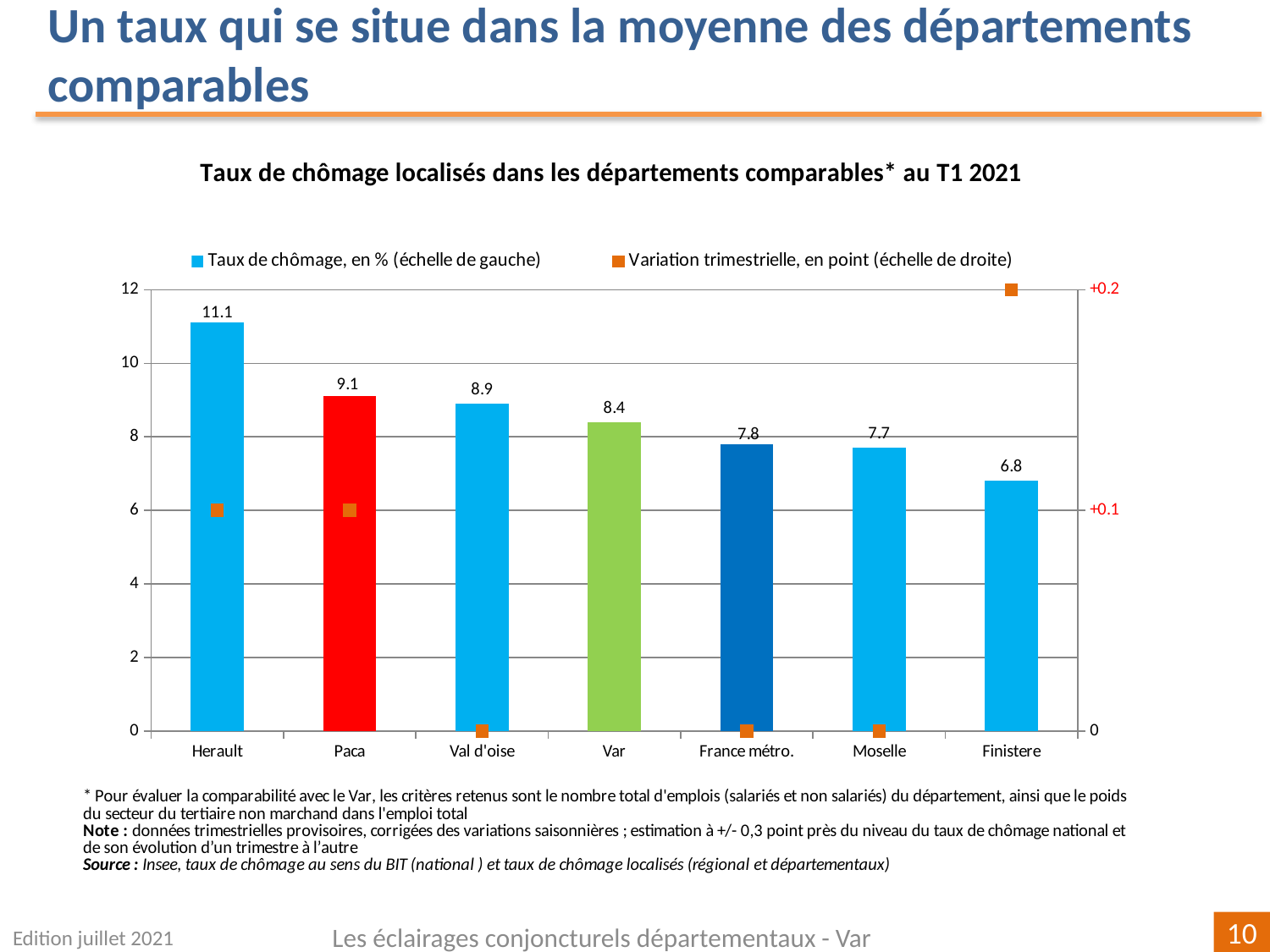
What is the unemployment rate shown for Moselle? 7.7 What kind of chart is this? Bar chart What is the quarterly variation (right axis) shown for Finistere? +0.2 Which has a higher unemployment rate, Paca or Val d'oise? Paca What is the difference between the unemployment rates of Herault and Finistere? 4.3 Which department has the lowest unemployment rate on the chart? Finistere What is the unemployment rate shown for Herault? 11.1 What is the unemployment rate shown for Var? 8.4 How many series does the legend list? 2 Which department has the highest unemployment rate on the chart? Herault How many departments or areas are shown on the x axis? 7 Do the unemployment rate bars rise or fall from left to right along the x axis? Fall